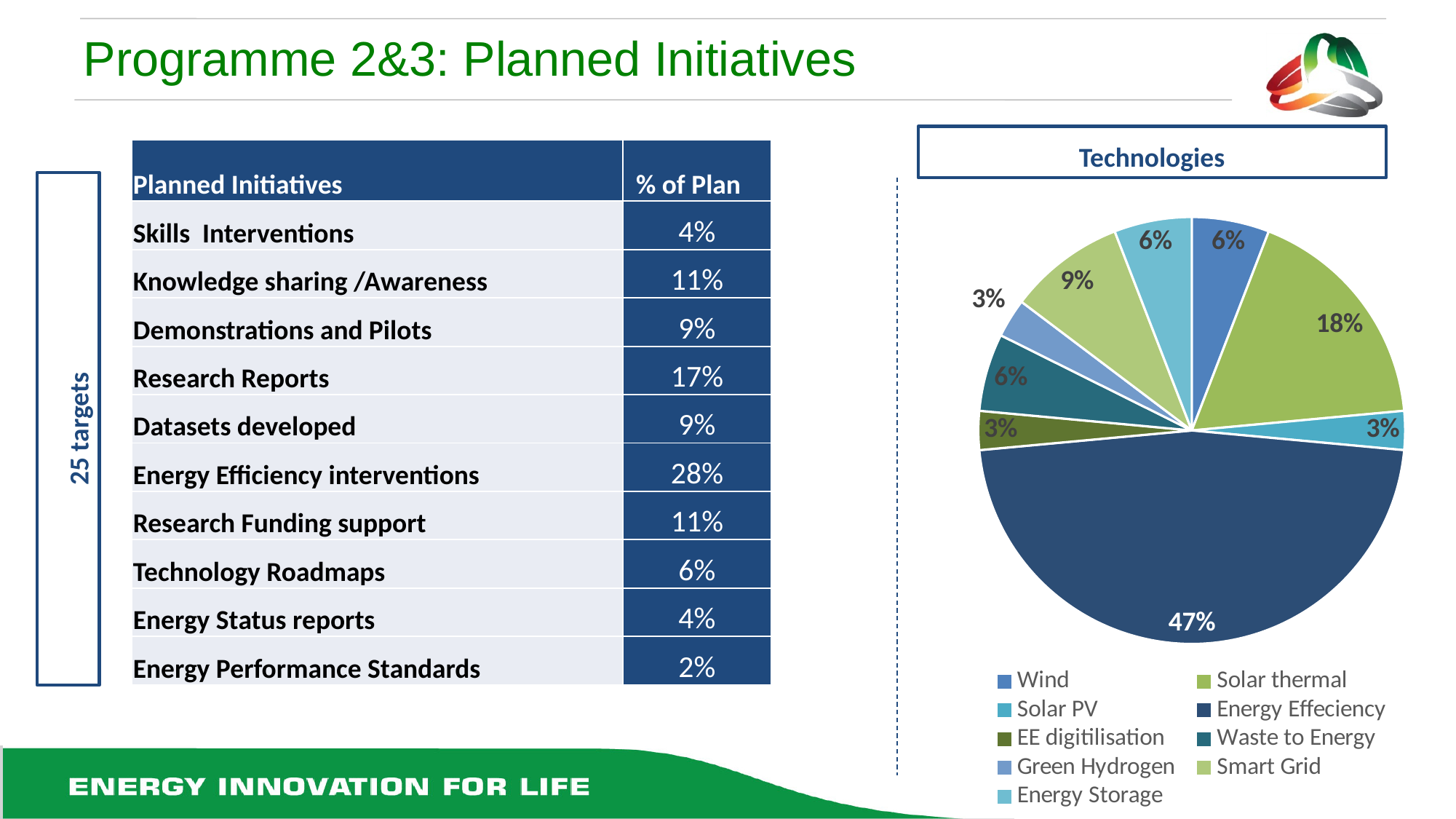
What is the title of the chart on the right of the slide? Technologies In the Technologies pie chart, which is larger: Smart Grid or Waste to Energy? Smart Grid What type of chart is shown under the title "Technologies"? pie chart In the Technologies pie chart, what percentage is shown for Green Hydrogen? 3% In the Technologies pie chart, what percentage is shown for Solar thermal? 18% In the Technologies pie chart, what is the difference between the Energy Effeciency and Solar thermal percentages? 29% In the Technologies pie chart, what percentage is shown for Wind? 6% How many slices does the Technologies pie chart have? 9 In the Technologies pie chart, what percentage is shown for Smart Grid? 9% Which technology has the largest slice in the Technologies pie chart? Energy Effeciency How many entries does the legend of the Technologies pie chart list? 9 In the Technologies pie chart, what percentage is shown for Energy Effeciency? 47%